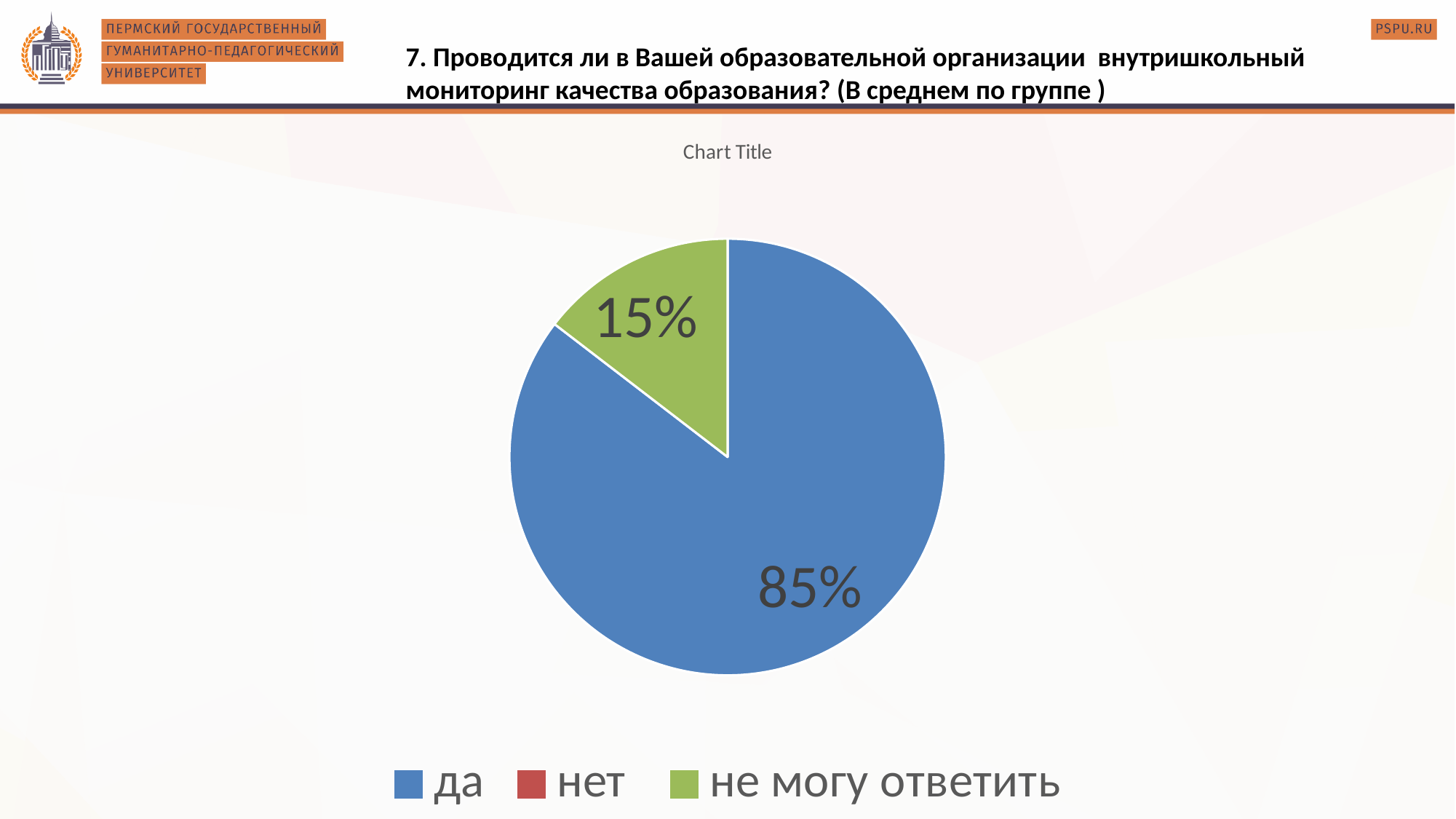
Which of the two visible slices is larger, "да" or "не могу ответить"? да How many entries does the legend list? 3 What is the difference in percentage points between the "да" slice and the "не могу ответить" slice? 70% Which legend entry is shown in green? не могу ответить Which category has the largest slice of the pie? да What share of the pie does the "не могу ответить" slice represent? 15% What share of the pie does the "да" slice represent? 85% What colour is the "да" slice? blue What kind of chart is shown on the slide? pie chart How many slices are visible in the pie? 2 What title is printed above the pie chart? Chart Title